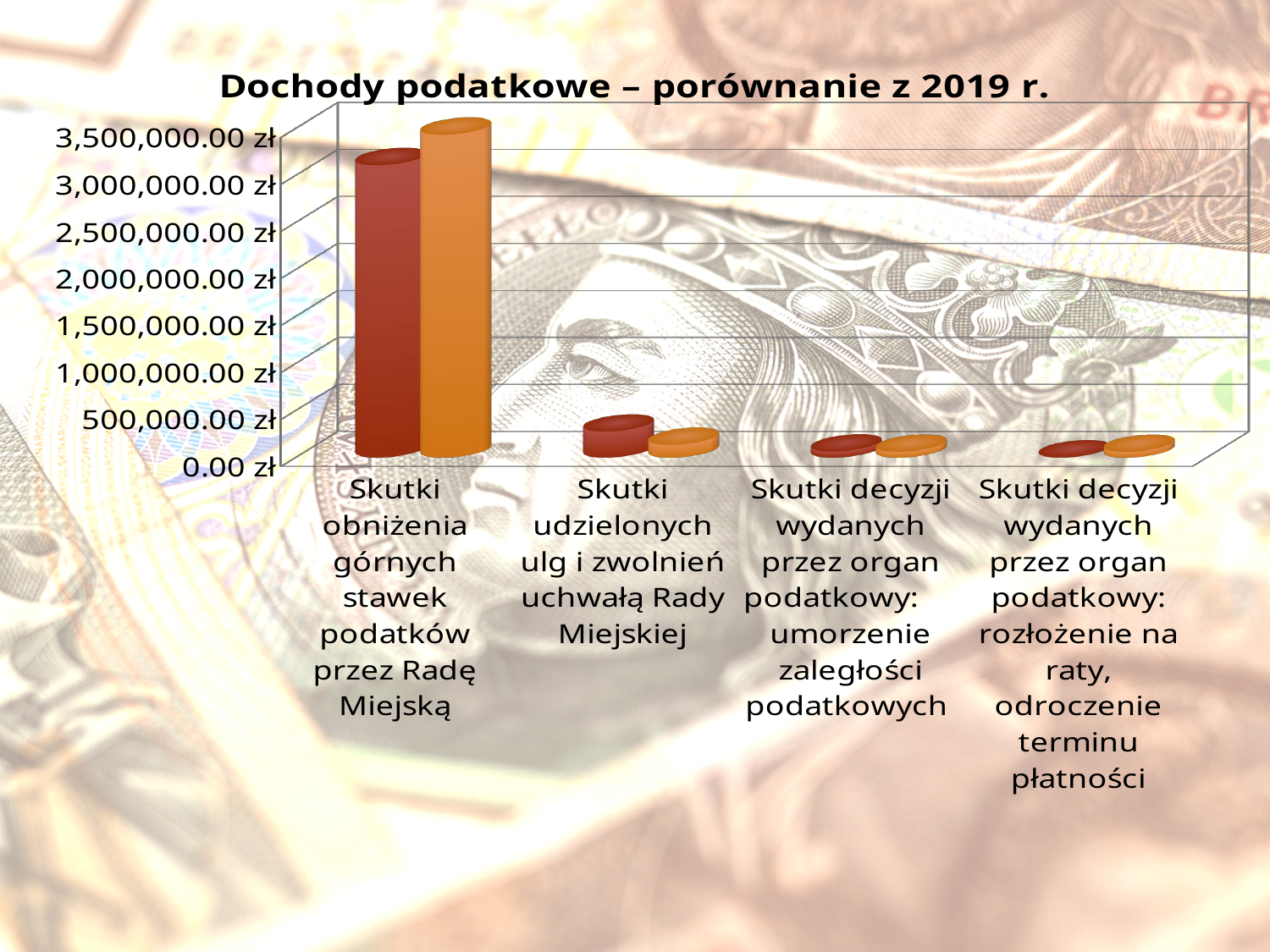
How many categories are shown on the x axis of the chart? 4 In the category 'Skutki udzielonych ulg i zwolnień uchwałą Rady Miejskiej', which bar is taller, the red one or the orange one? The red one Is the red bar for 'Skutki udzielonych ulg i zwolnień uchwałą Rady Miejskiej' greater or less than 500,000.00 zł? less Is the red bar for 'Skutki obniżenia górnych stawek podatków przez Radę Miejską' greater or less than 2,500,000.00 zł? greater Is the orange bar for 'Skutki obniżenia górnych stawek podatków przez Radę Miejską' greater or less than 3,000,000.00 zł? greater How many bars are plotted for each category in the chart? 2 What is the title of the chart? Dochody podatkowe – porównanie z 2019 r. Which category has the tallest bars in the chart? Skutki obniżenia górnych stawek podatków przez Radę Miejską Which category has the shortest bars in the chart? Skutki decyzji wydanych przez organ podatkowy: rozłożenie na raty, odroczenie terminu płatności What kind of chart is shown on the slide? Bar chart In the category 'Skutki obniżenia górnych stawek podatków przez Radę Miejską', which bar is taller, the red one or the orange one? The orange one Do the bar heights generally rise or fall moving from left to right along the x axis? Fall